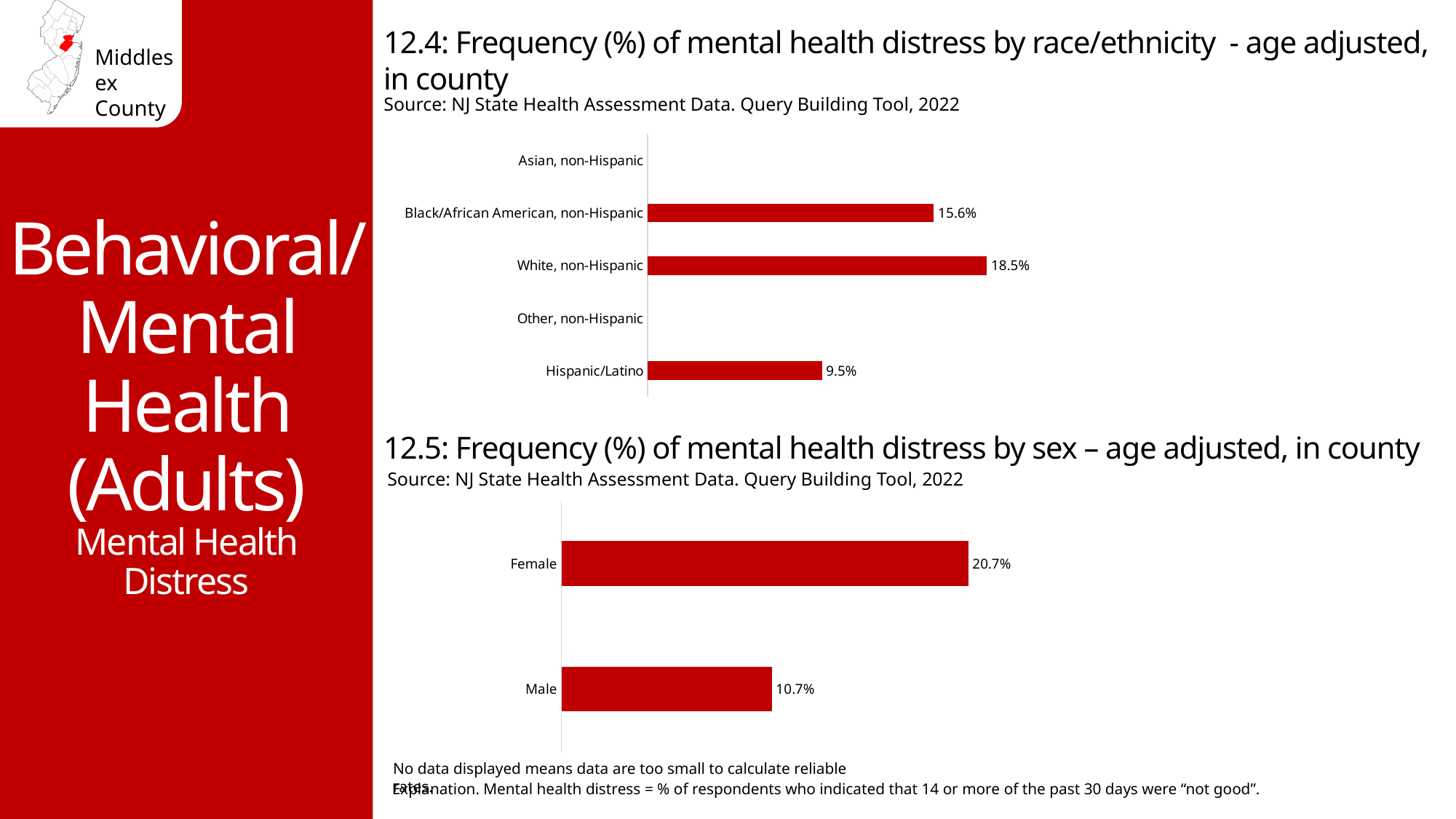
In chart 12.5 (mental health distress by sex), what is the value for Male? 10.7% In chart 12.4 (mental health distress by race/ethnicity), what is the difference between the White, non-Hispanic and Hispanic/Latino values? 9.0% In chart 12.4 (mental health distress by race/ethnicity), which race/ethnicity group has the highest value? White, non-Hispanic In chart 12.4 (mental health distress by race/ethnicity), what is the value for White, non-Hispanic? 18.5% In chart 12.5 (mental health distress by sex), what is the difference between the Female and Male values? 10.0% In chart 12.4 (mental health distress by race/ethnicity), what is the value for Hispanic/Latino? 9.5% In chart 12.5 (mental health distress by sex), what is the value for Female? 20.7% What kind of chart is chart 12.5 (mental health distress by sex)? Bar chart In chart 12.5 (mental health distress by sex), which is larger, the Female value or the Male value? Female In chart 12.4 (mental health distress by race/ethnicity), how many race/ethnicity categories are listed on the axis? 5 In chart 12.4 (mental health distress by race/ethnicity), what is the value for Black/African American, non-Hispanic? 15.6% In chart 12.4 (mental health distress by race/ethnicity), how many categories have a bar displayed? 3